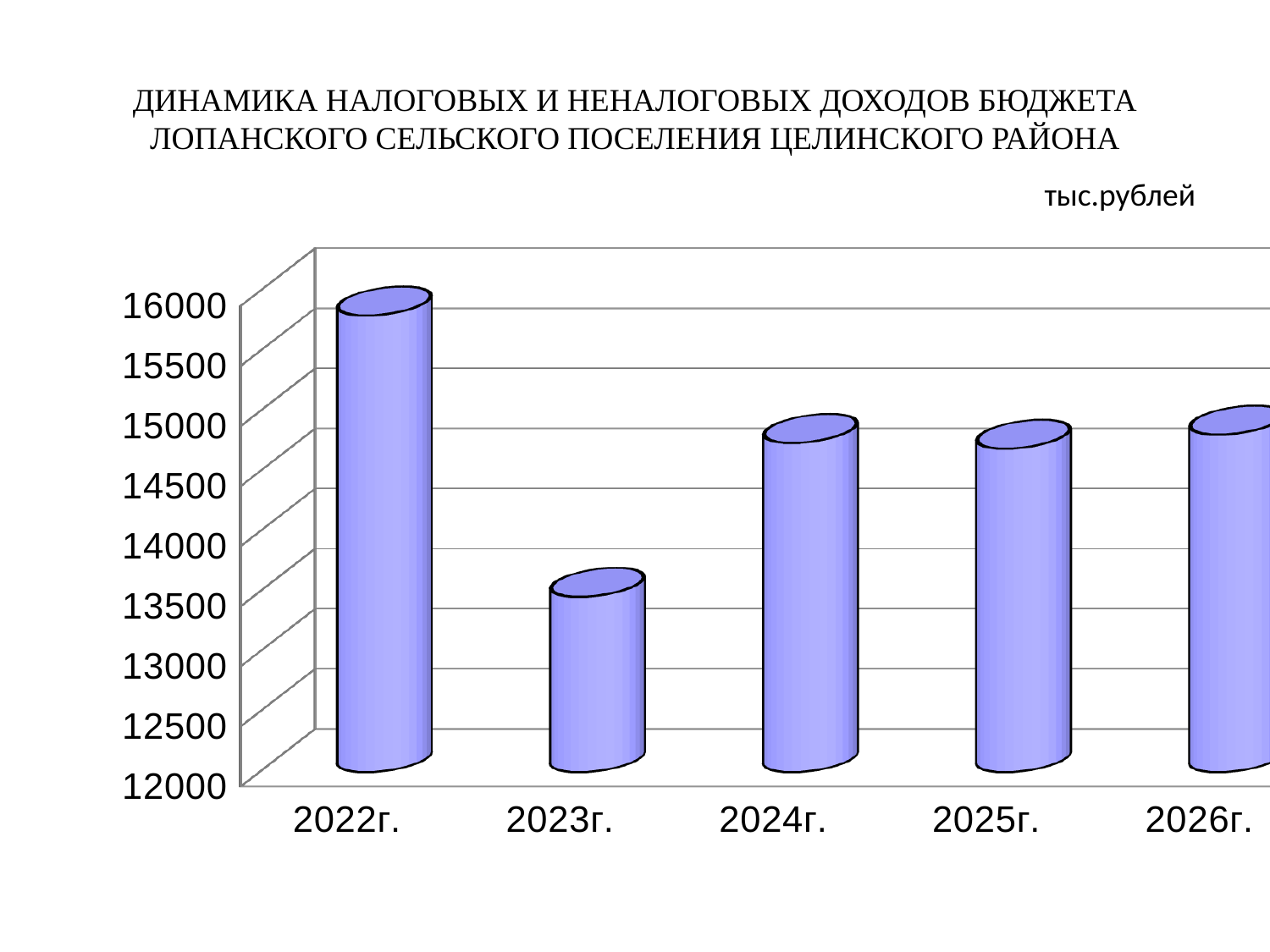
What kind of chart is shown on the slide? bar chart Is the value for 2023г. greater or less than 13000? greater Is the value for 2023г. greater or less than 14000? less Which is larger, the value for 2023г. or the value for 2024г.? 2024г. In what units are the values of the chart given, according to the label above the chart? тыс.рублей Does the value rise or fall from 2022г. to 2023г.? fall Is the value for 2025г. greater or less than 15000? less Which year has the lowest value in the chart? 2023г. Which year has the highest value in the chart? 2022г. How many years are shown on the x axis of the chart? 5